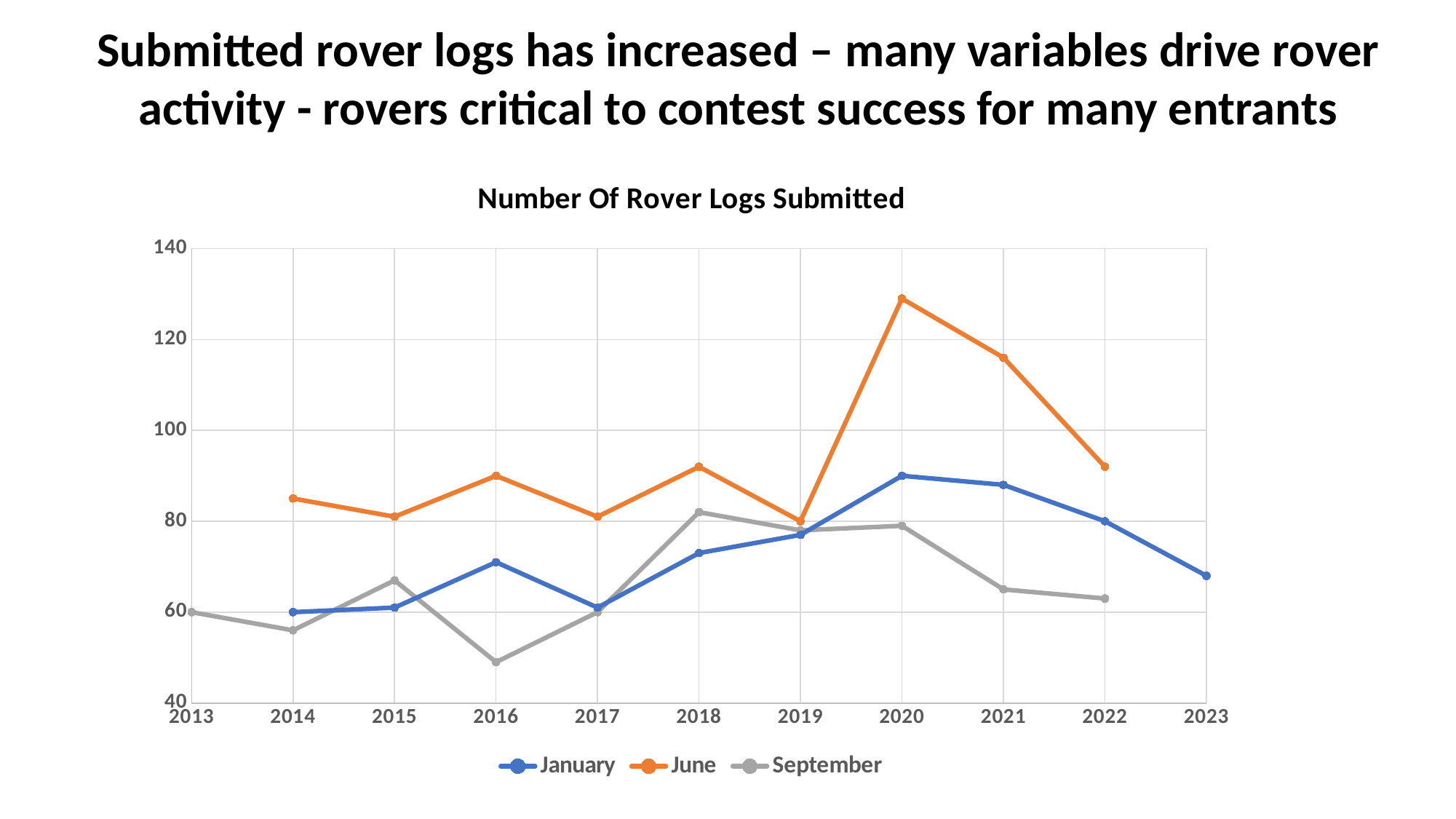
In which year does the January series reach its highest value? 2020 In which year does the June series reach its highest value? 2020 Is the September value for 2016 greater or less than 60? less In 2021, which series has the larger value, January or June? June What is the title of the chart? Number Of Rover Logs Submitted How many series does the legend list? 3 Is the January value for 2023 greater or less than 80? less Is the June value for 2020 greater or less than 120? greater Which series are listed in the legend? January, June, September What kind of chart is shown on the slide? line chart How many years are shown along the x axis? 11 In which year does the September series reach its lowest value? 2016